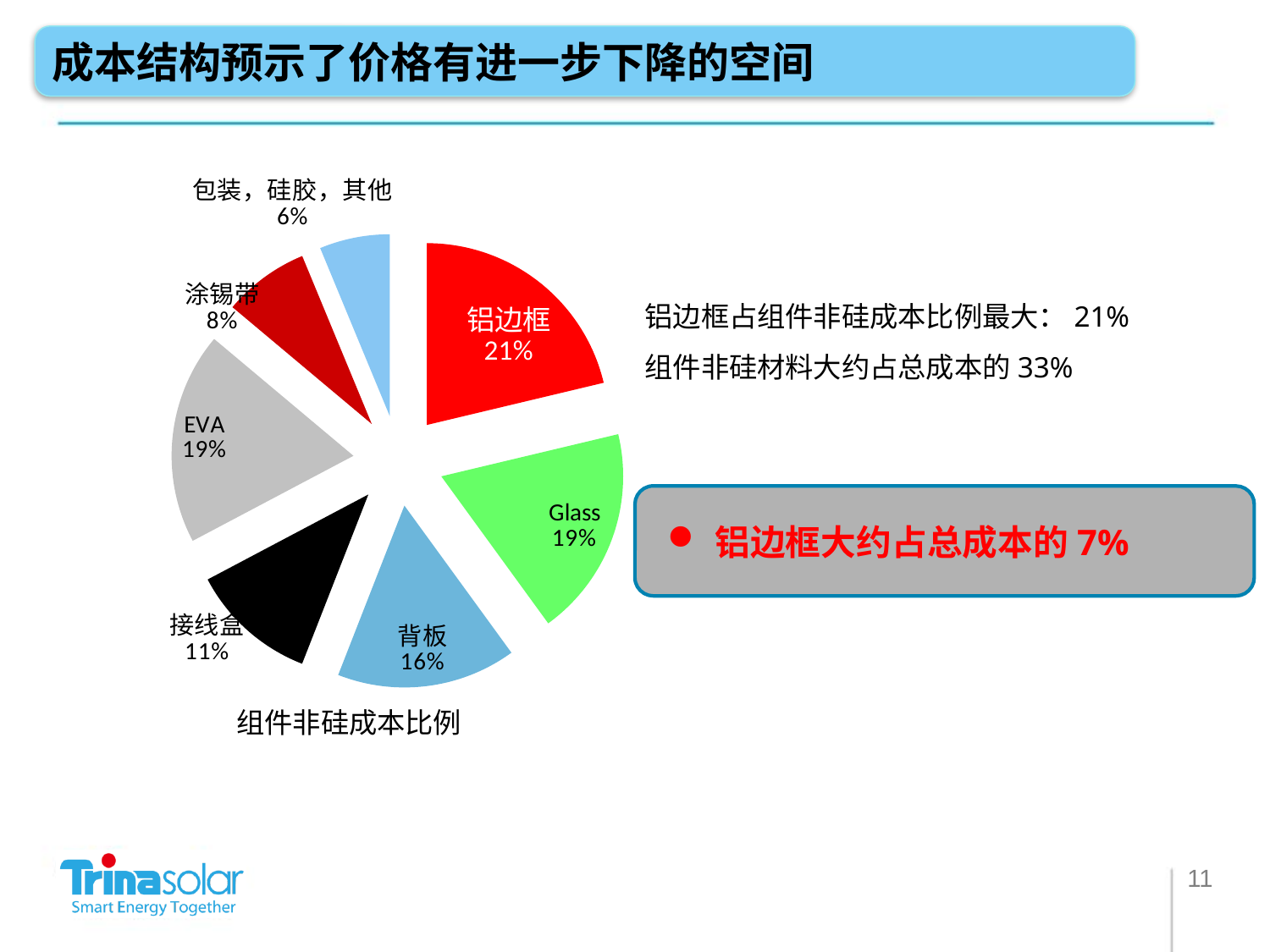
What is the value shown for 背板? 16% Which is larger, the share for EVA or the share for 接线盒? EVA What is the value shown for Glass? 19% What is the value shown for 接线盒? 11% What is the value shown for 涂锡带? 8% What type of chart is shown on the slide? Pie chart How many slices does the pie chart have? 7 What is the title of the pie chart? 组件非硅成本比例 Which category has the smallest share of the pie? 包装，硅胶，其他 What share of the pie does 铝边框 account for? 21% Which category has the largest share of the pie? 铝边框 What is the difference between the shares of 铝边框 and 背板? 5%